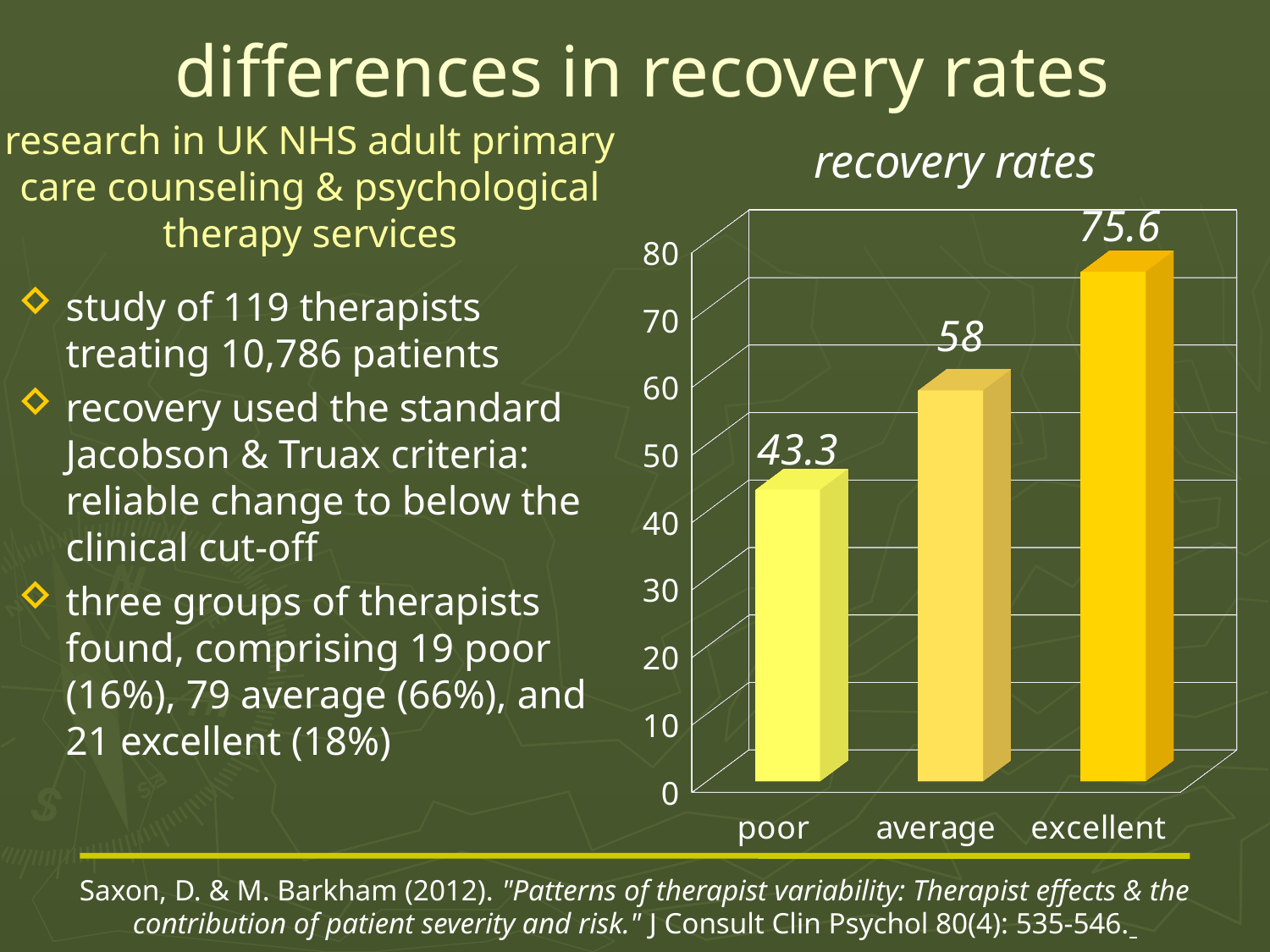
What is the recovery rate for the excellent therapist group? 75.6 What kind of chart is used to show the recovery rates? bar chart How many therapist groups are shown in the chart? 3 Which therapist group has the lowest recovery rate? poor What is the recovery rate for the poor therapist group? 43.3 What is the title of the chart? recovery rates Which therapist group has the highest recovery rate? excellent Which has a higher recovery rate, the average group or the poor group? average What is the difference between the recovery rates of the average and poor groups? 14.7 What is the difference between the recovery rates of the excellent and poor groups? 32.3 What is the recovery rate for the average therapist group? 58 Is the recovery rate for the average group greater or less than 50? greater